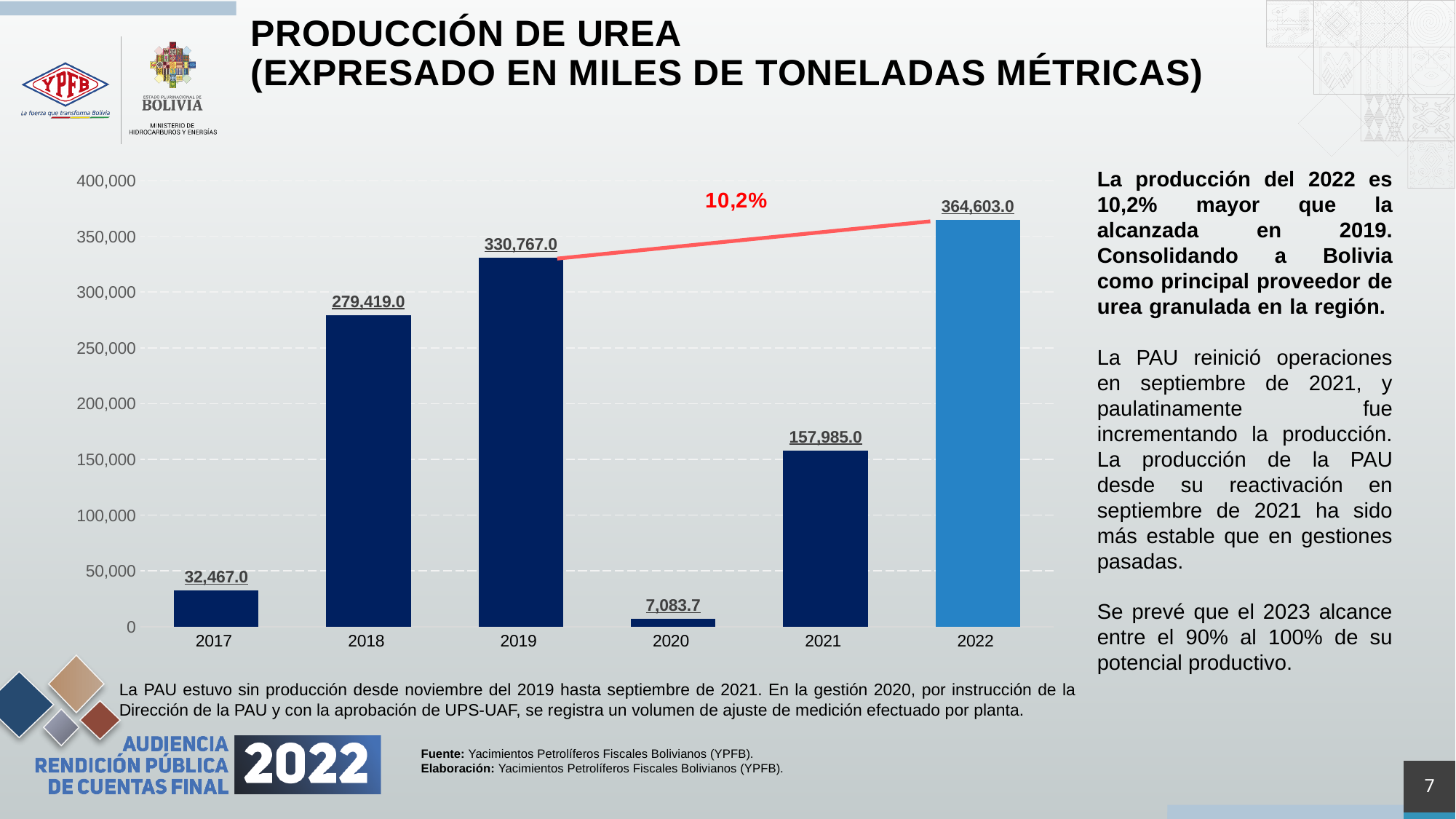
What percentage increase is annotated between the 2019 and 2022 bars? 10,2% What is the urea production value shown for 2021? 157,985.0 How many years are shown on the x axis of the chart? 6 Which year had higher urea production, 2018 or 2021? 2018 Which year has the lowest urea production in the chart? 2020 Which year has the highest urea production in the chart? 2022 Is the urea production value for 2021 greater or less than 150,000? greater What type of chart is used to show urea production? bar chart What is the urea production value shown for 2020? 7,083.7 What is the difference between the urea production in 2022 and in 2019? 33,836.0 What is the urea production value shown for 2019? 330,767.0 What is the difference between the urea production in 2018 and in 2017? 246,952.0